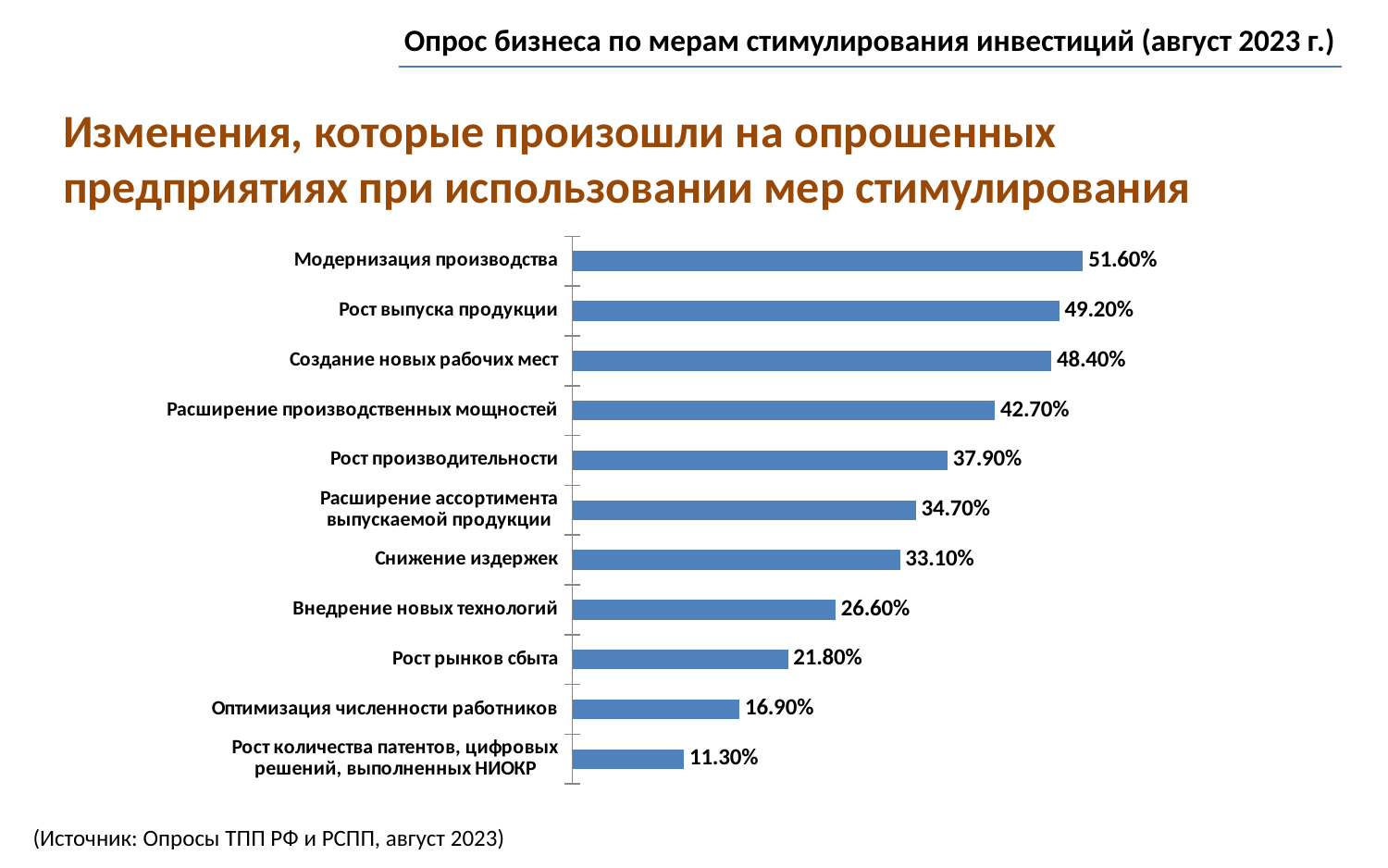
Which category has the highest value? Модернизация производства What is the value for «Модернизация производства»? 51.60% What is the value for «Снижение издержек»? 33.10% Which category has the lowest value? Рост количества патентов, цифровых решений, выполненных НИОКР What is the value for «Расширение ассортимента выпускаемой продукции»? 34.70% What source is cited at the bottom of the slide? Опросы ТПП РФ и РСПП, август 2023 What is the difference between «Модернизация производства» and «Оптимизация численности работников»? 34.70% How many categories are shown in the chart? 11 What kind of chart is shown on the slide? Bar chart What is the difference between «Рост выпуска продукции» and «Создание новых рабочих мест»? 0.80% Which is larger: «Рост производительности» or «Внедрение новых технологий»? Рост производительности What is the value for «Рост рынков сбыта»? 21.80%